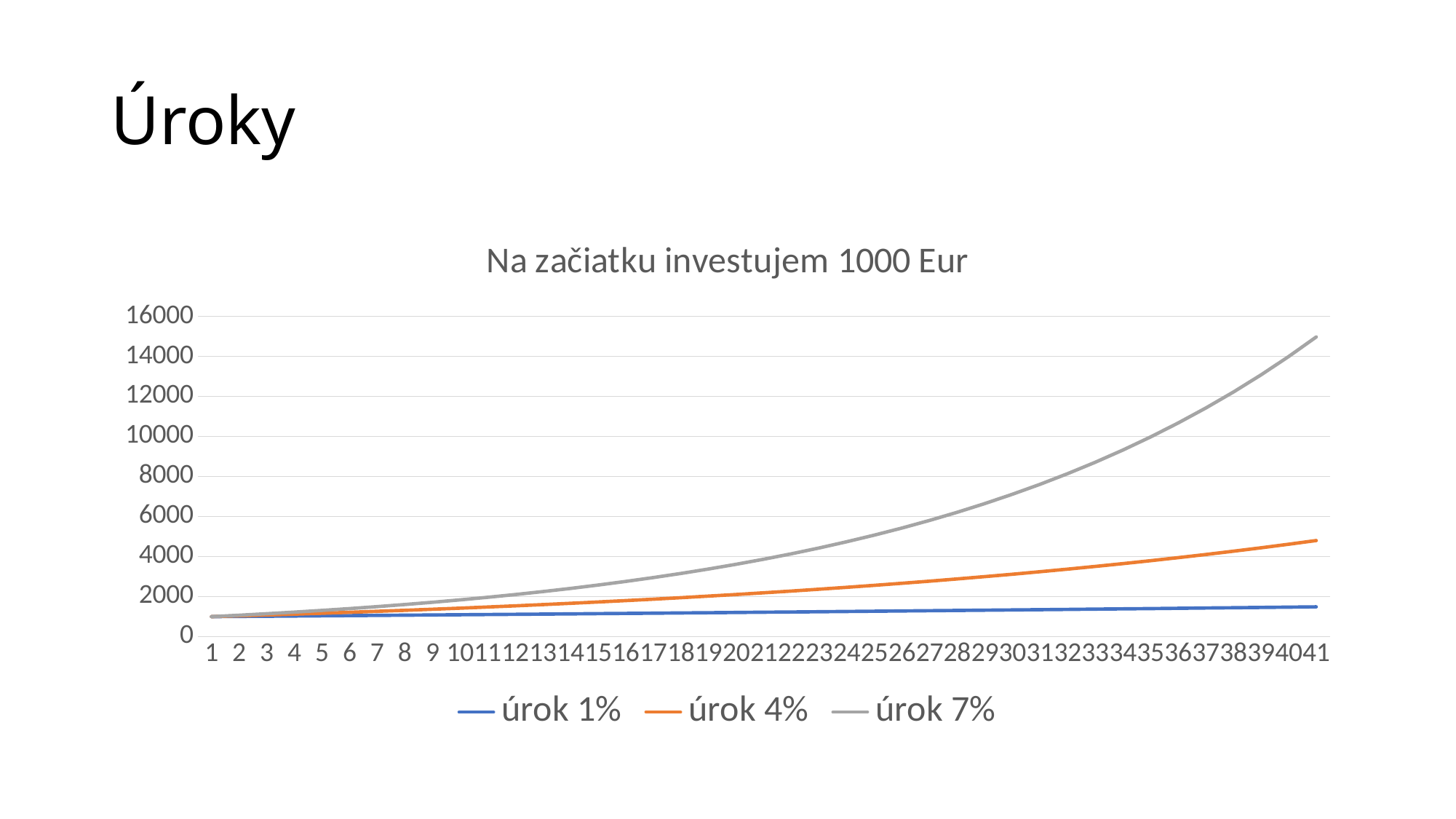
Is the value for úrok 1% at point 41 greater or less than 2000? less What is the title of the chart? Na začiatku investujem 1000 Eur What kind of chart is shown on the slide? line chart At point 41, which is larger: the value for úrok 4% or the value for úrok 7%? úrok 7% How many points are on the x axis of the chart? 41 Is the value for úrok 7% at point 41 greater or less than 14000? greater What are the three series named in the legend? úrok 1%, úrok 4%, úrok 7% Which series has the lowest value at point 41? úrok 1% Is the value for úrok 4% at point 41 greater or less than 6000? less Do the values of the úrok 7% series rise or fall along the x axis? rise Which series has the highest value at point 41? úrok 7% How many series does the legend list? 3